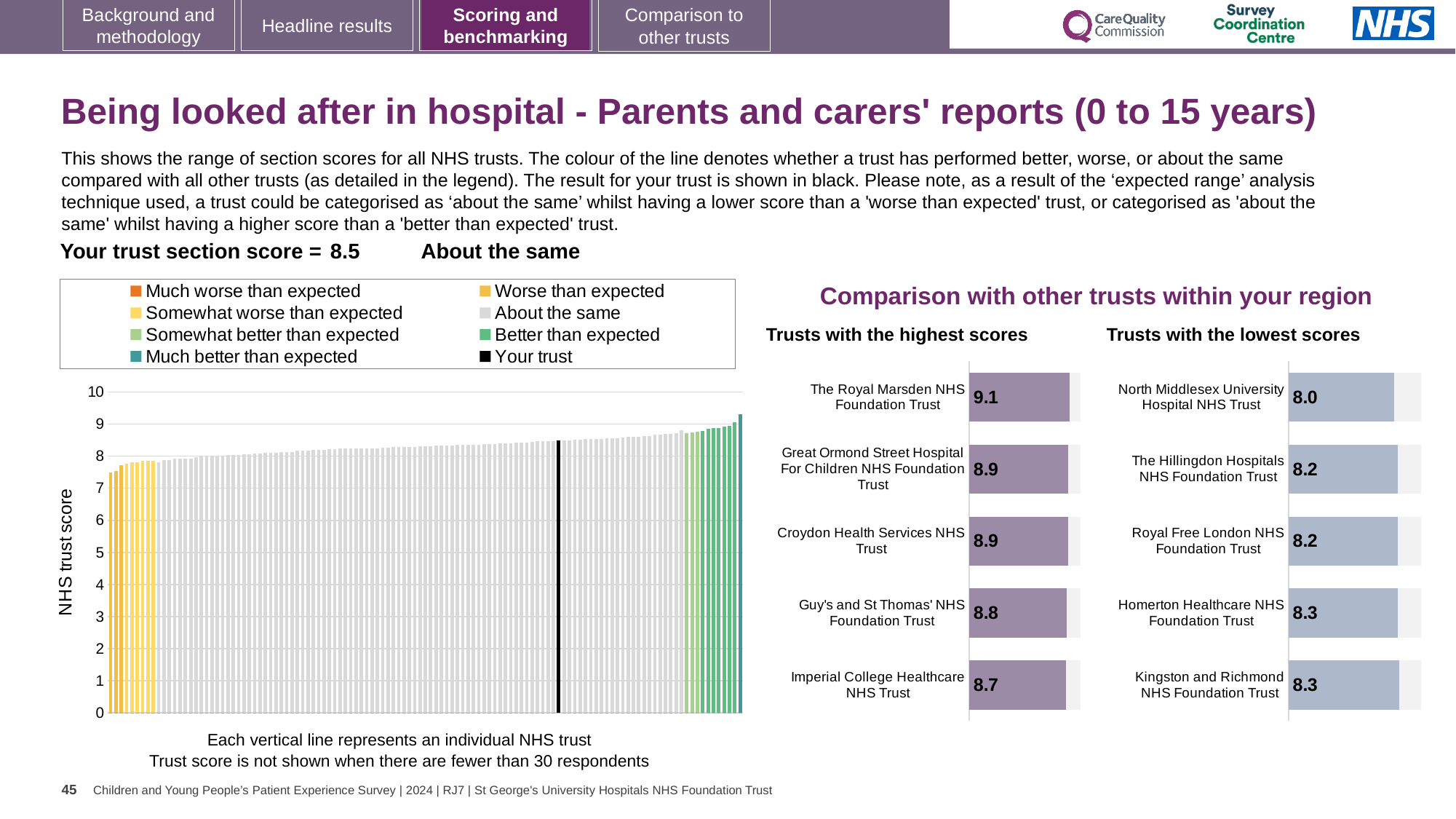
In the NHS trust score chart on the left, do the bar values rise or fall from left to right? rise In the 'Trusts with the highest scores' chart, what is the score for Imperial College Healthcare NHS Trust? 8.7 In the 'Trusts with the highest scores' chart, what is the score for The Royal Marsden NHS Foundation Trust? 9.1 In the 'Trusts with the lowest scores' chart, which trust has the lowest score? North Middlesex University Hospital NHS Trust In the 'Trusts with the highest scores' chart, which trust has the highest score? The Royal Marsden NHS Foundation Trust In the 'Trusts with the lowest scores' chart, which has the larger score: The Hillingdon Hospitals NHS Foundation Trust or Homerton Healthcare NHS Foundation Trust? Homerton Healthcare NHS Foundation Trust In the 'Trusts with the lowest scores' chart, what is the difference between the scores of Homerton Healthcare NHS Foundation Trust and North Middlesex University Hospital NHS Trust? 0.3 How many trusts are shown in the 'Trusts with the highest scores' chart? 5 In the NHS trust score chart on the left, is the value for the black 'Your trust' bar greater or less than 8? greater In the 'Trusts with the highest scores' chart, what is the difference between the scores of The Royal Marsden NHS Foundation Trust and Imperial College Healthcare NHS Trust? 0.4 In the 'Trusts with the lowest scores' chart, what is the score for North Middlesex University Hospital NHS Trust? 8.0 How many entries does the legend of the NHS trust score chart on the left list? 8